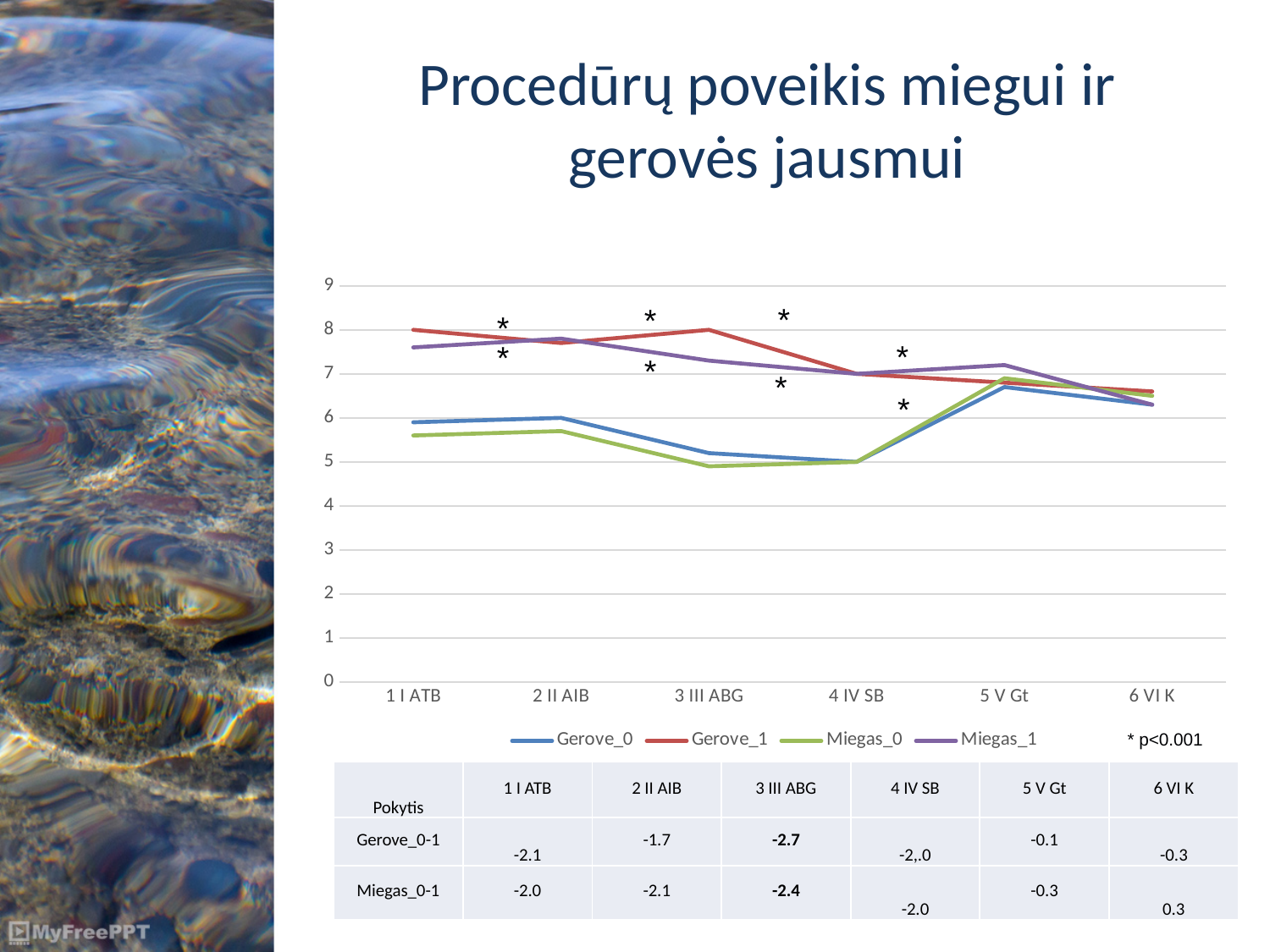
Is the value of Gerove_1 at 1 I ATB greater or less than 7? greater At 1 I ATB, which series has the larger value, Gerove_1 or Gerove_0? Gerove_1 What are the four series names listed in the chart legend? Gerove_0, Gerove_1, Miegas_0, Miegas_1 At 3 III ABG, which series has the larger value, Gerove_1 or Miegas_1? Gerove_1 At which category does the Miegas_0 series reach its highest value? 5 V Gt Is the value of Gerove_0 at 4 IV SB greater or less than 6? less What kind of chart is shown on the slide? line chart How many categories are shown along the x axis of the chart? 6 Does the Gerove_1 series rise or fall from 3 III ABG to 6 VI K? fall Is the value of Miegas_0 at 3 III ABG greater or less than 6? less How many series does the chart legend list? 4